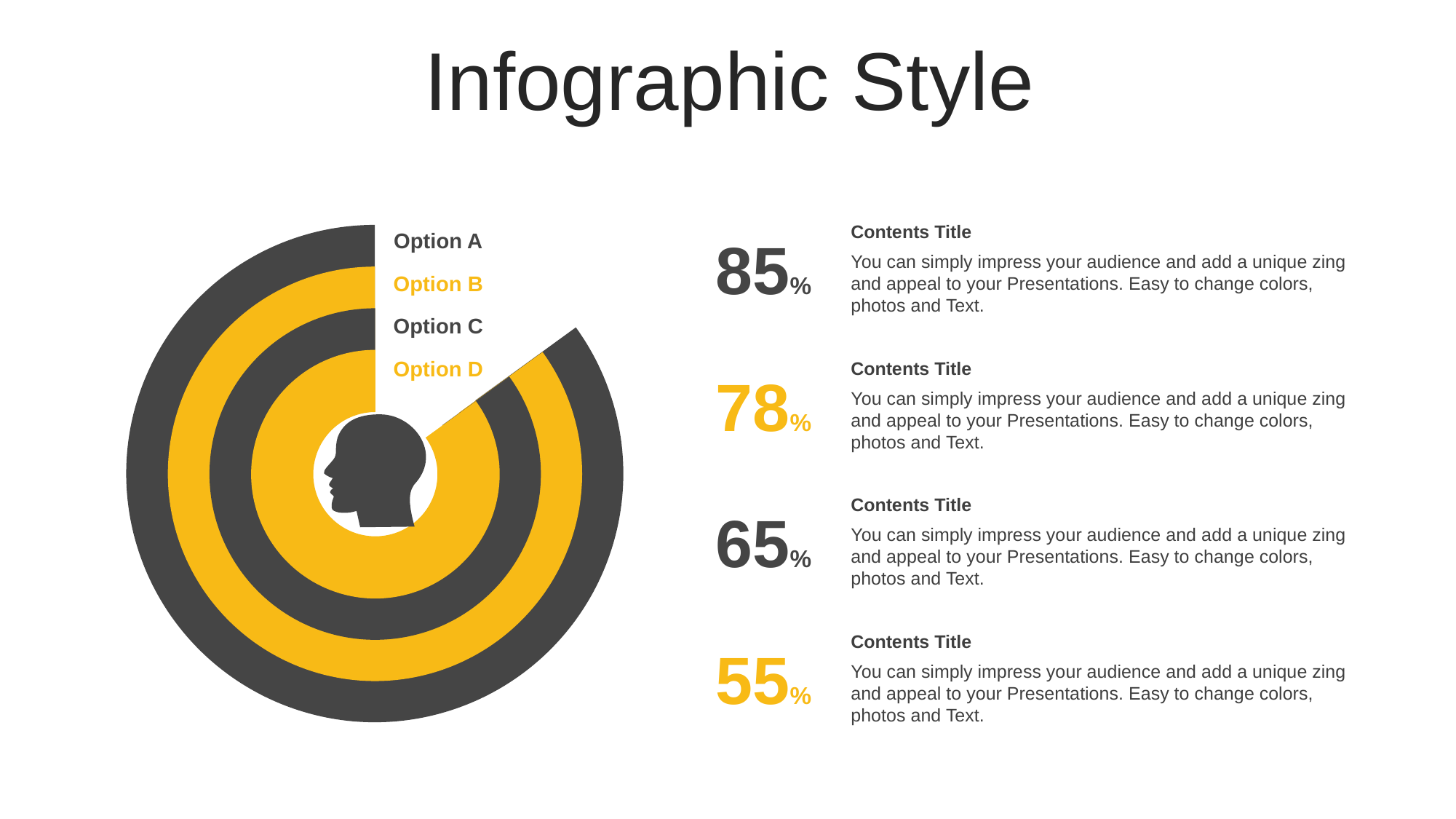
Which option is the outermost ring of the chart? Option A What kind of chart is shown on the left of the slide? A concentric ring (doughnut) chart Which is larger, the second percentage listed (78%) or the third (65%)? 78% How many options are labelled on the ring chart? 4 Do the percentages listed beside the chart increase or decrease from top to bottom? Decrease What is the third percentage listed beside the chart? 65% What is the second percentage listed beside the chart? 78% What is the highest percentage listed beside the chart? 85% What is the difference between the highest and lowest percentages listed on the slide? 30% What is the lowest percentage listed beside the chart? 55% Which option is the innermost ring of the chart? Option D